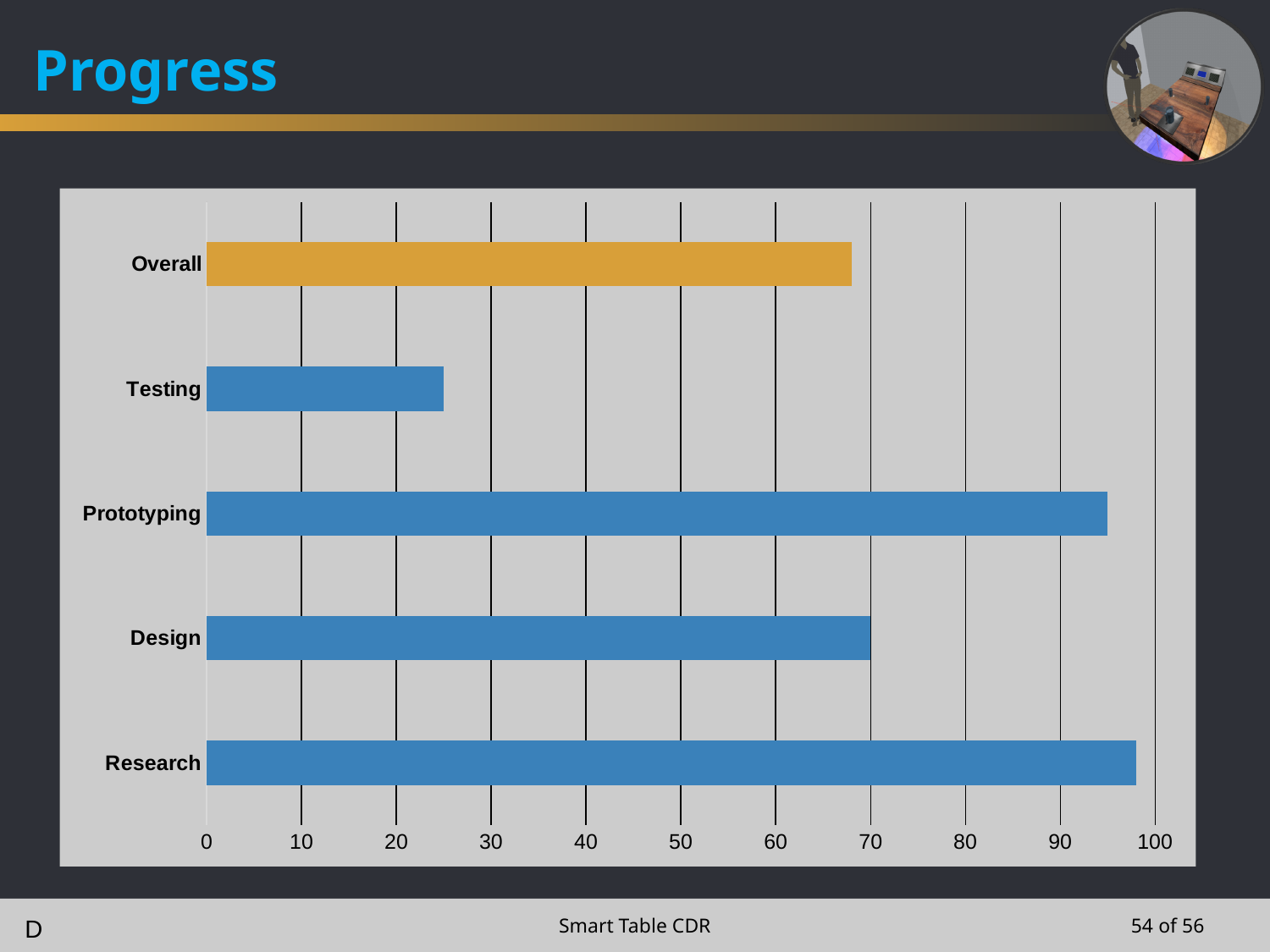
Is the value for Design greater or less than 60? greater Is the value for Testing greater or less than 20? greater Is the value for Prototyping greater or less than 90? greater What kind of chart is shown on the slide? bar chart Which bar is coloured differently from the others? Overall Which is larger, the value for Prototyping or the value for Overall? Prototyping Which is larger, the value for Design or the value for Testing? Design Which category has the lowest value? Testing How many categories are plotted on the chart? 5